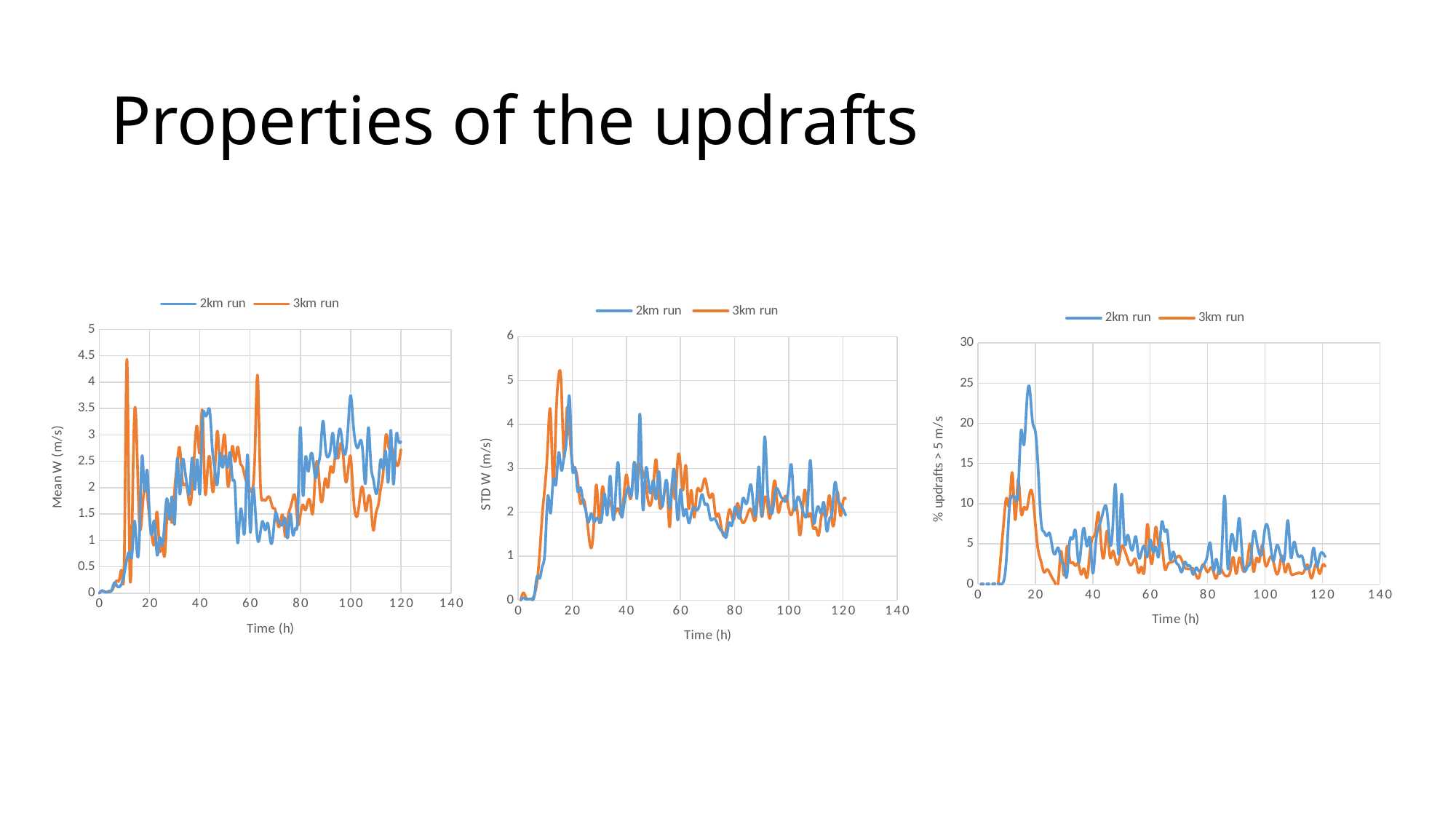
In the left chart (Mean W), is the peak value of the 3km run greater or less than 4? greater What are the two series named in the legend of the right chart (% updrafts > 5 m/s)? 2km run and 3km run In the left chart (Mean W), is the peak value of the 2km run greater or less than 4? less In the middle chart (STD W), is the peak value of the 2km run greater or less than 5? less What is the y-axis title of the middle chart? STD W (m/s) What kind of chart is the left chart (Mean W)? line chart In the middle chart (STD W), which series reaches the higher peak, the 2km run or the 3km run? 3km run In the right chart (% updrafts > 5 m/s), which series reaches the higher peak, the 2km run or the 3km run? 2km run How many series does the legend of the middle chart (STD W) list? 2